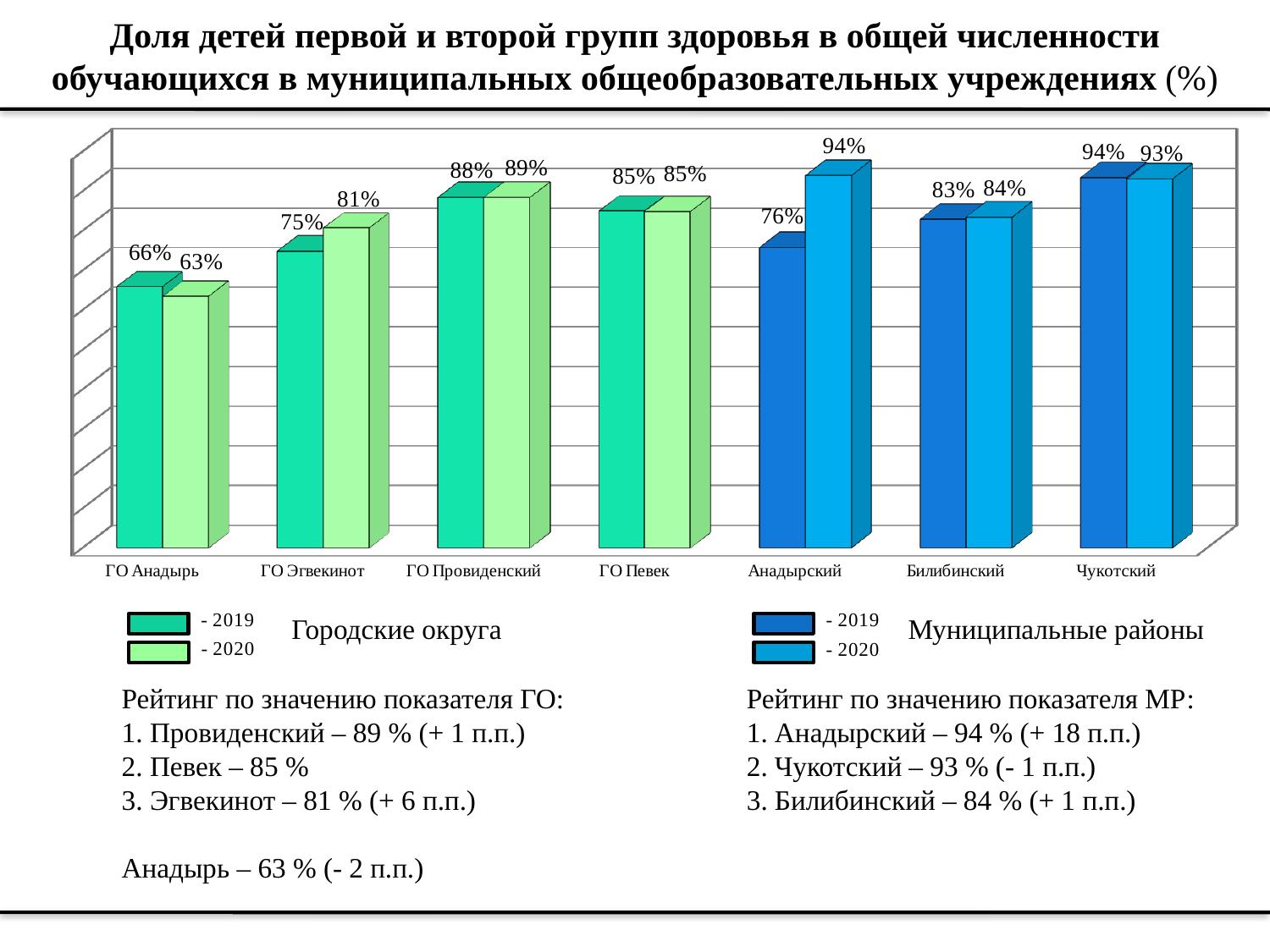
What is the 2020 value for ГО Эгвекинот? 81% What is the 2020 value for ГО Анадырь? 63% Which colour represents the 2020 series for the municipal districts (Муниципальные районы)? Light blue How many categories are shown on the x axis? 7 What is the 2019 value for Анадырский? 76% What is the difference between the 2019 values for ГО Провиденский and ГО Анадырь? 22 percentage points Which category has the lowest 2020 value? ГО Анадырь What kind of chart is shown on the slide? Bar chart Which is larger, the 2020 value for Билибинский or the 2020 value for ГО Певек? ГО Певек Which category has the highest 2019 value? Чукотский What is the difference between the 2020 and 2019 values for Анадырский? 18 percentage points How many years (series) are plotted for each category? 2